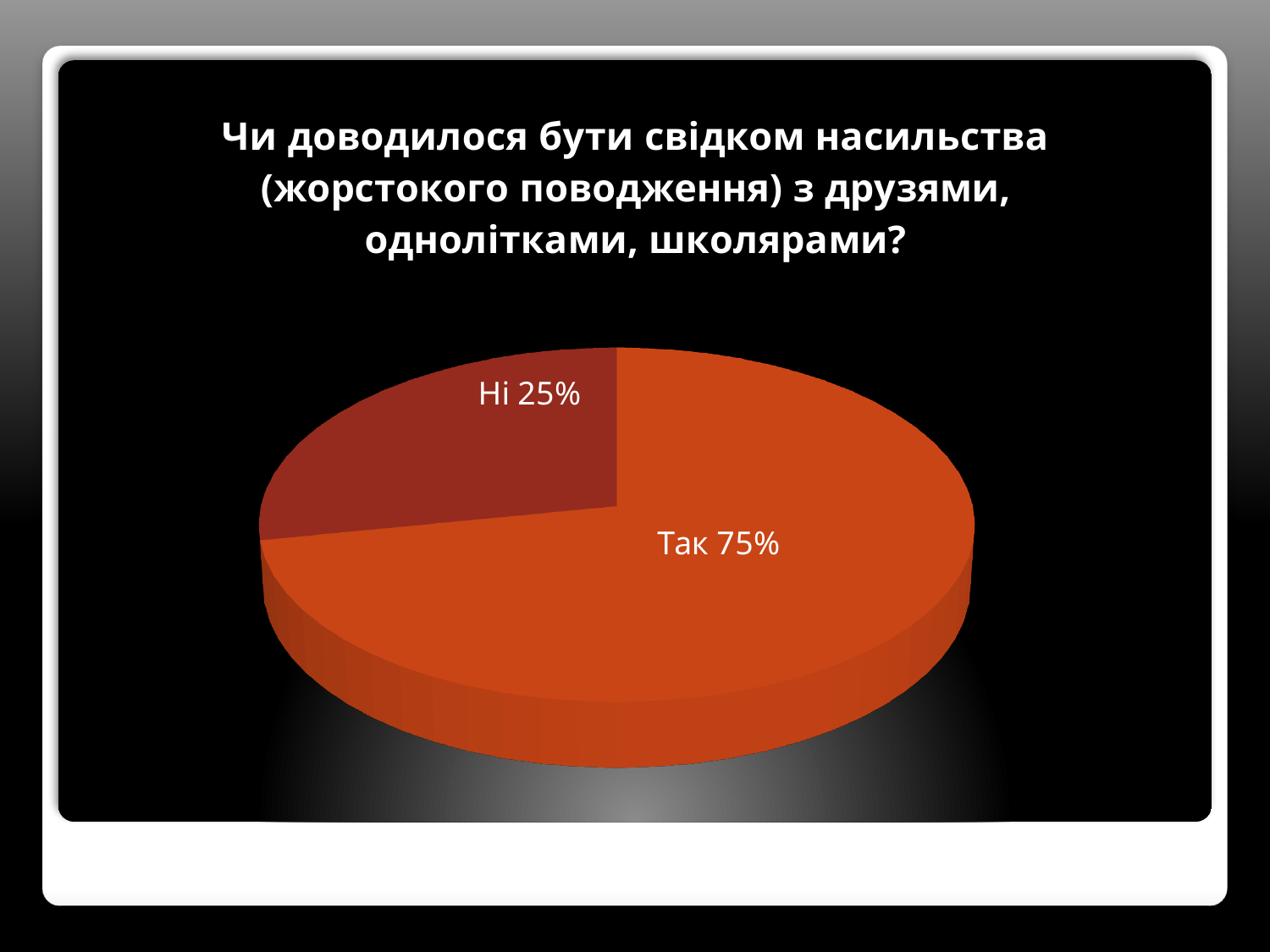
What is the difference in percentage points between the "Так" and "Ні" slices? 50 What share of the pie does the "Ні" slice represent? 25% Which slice is the smallest in the pie chart? Ні How many slices does the pie chart have? 2 What share of the pie does the "Так" slice represent? 75% What kind of chart is shown on the slide? Pie chart Which is larger, the "Так" slice or the "Ні" slice? Так What is the total of the two slice percentages shown? 100% Which slice is the largest in the pie chart? Так What is the title of the chart? Чи доводилося бути свідком насильства (жорстокого поводження) з друзями, однолітками, школярами?